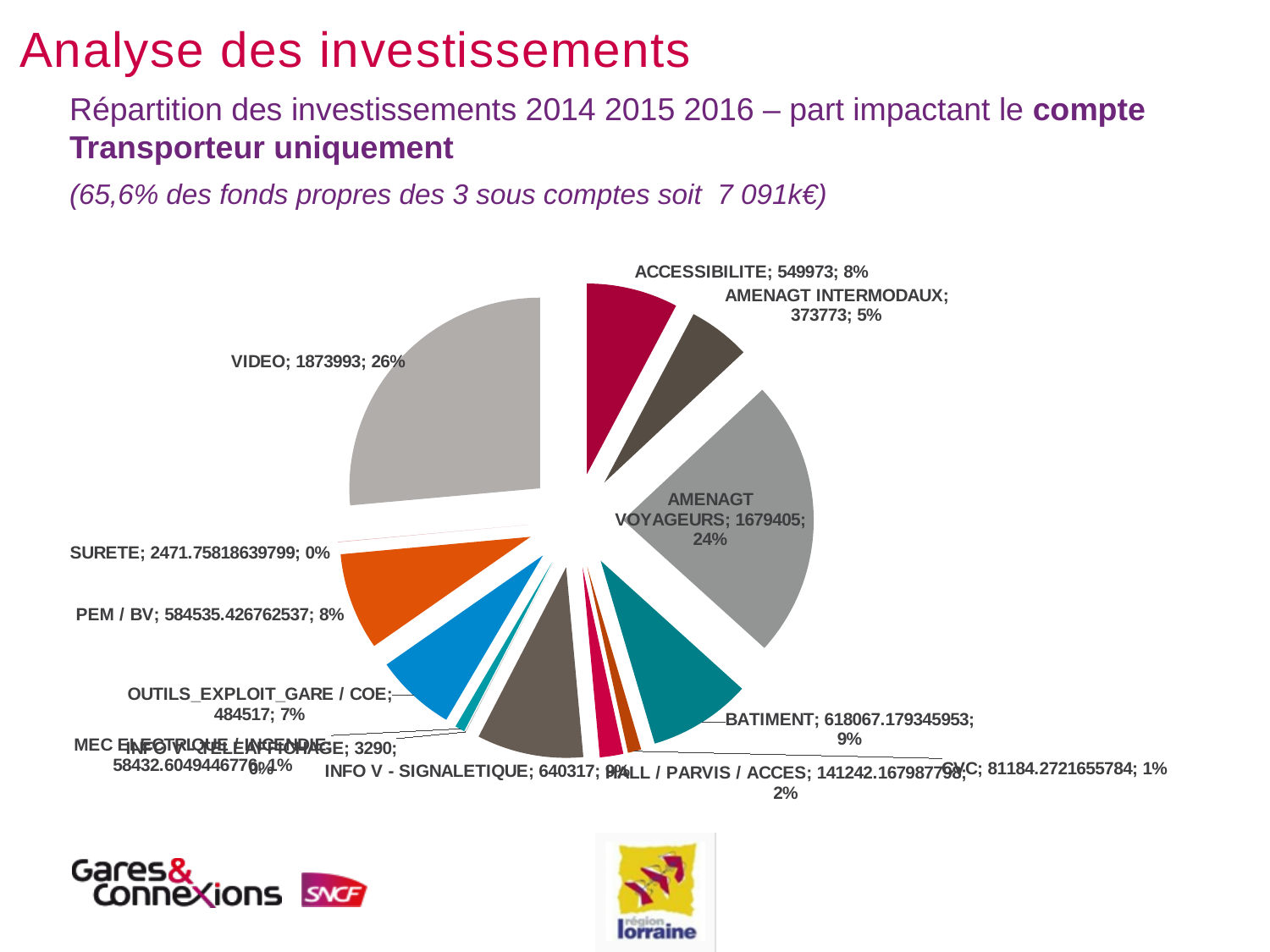
What share of the pie does VIDEO represent? 26% What percentage share is shown for PEM / BV? 8% What kind of chart is shown on the slide? pie chart What is the value shown for ACCESSIBILITE? 549973 What is the value shown for OUTILS_EXPLOIT_GARE / COE? 484517 Which category has the largest slice of the pie? VIDEO Which is larger, ACCESSIBILITE or AMENAGT INTERMODAUX? ACCESSIBILITE What is the value shown for AMENAGT VOYAGEURS? 1679405 What percentage share is shown for BATIMENT? 9% What is the difference between the values for VIDEO and AMENAGT VOYAGEURS? 194588